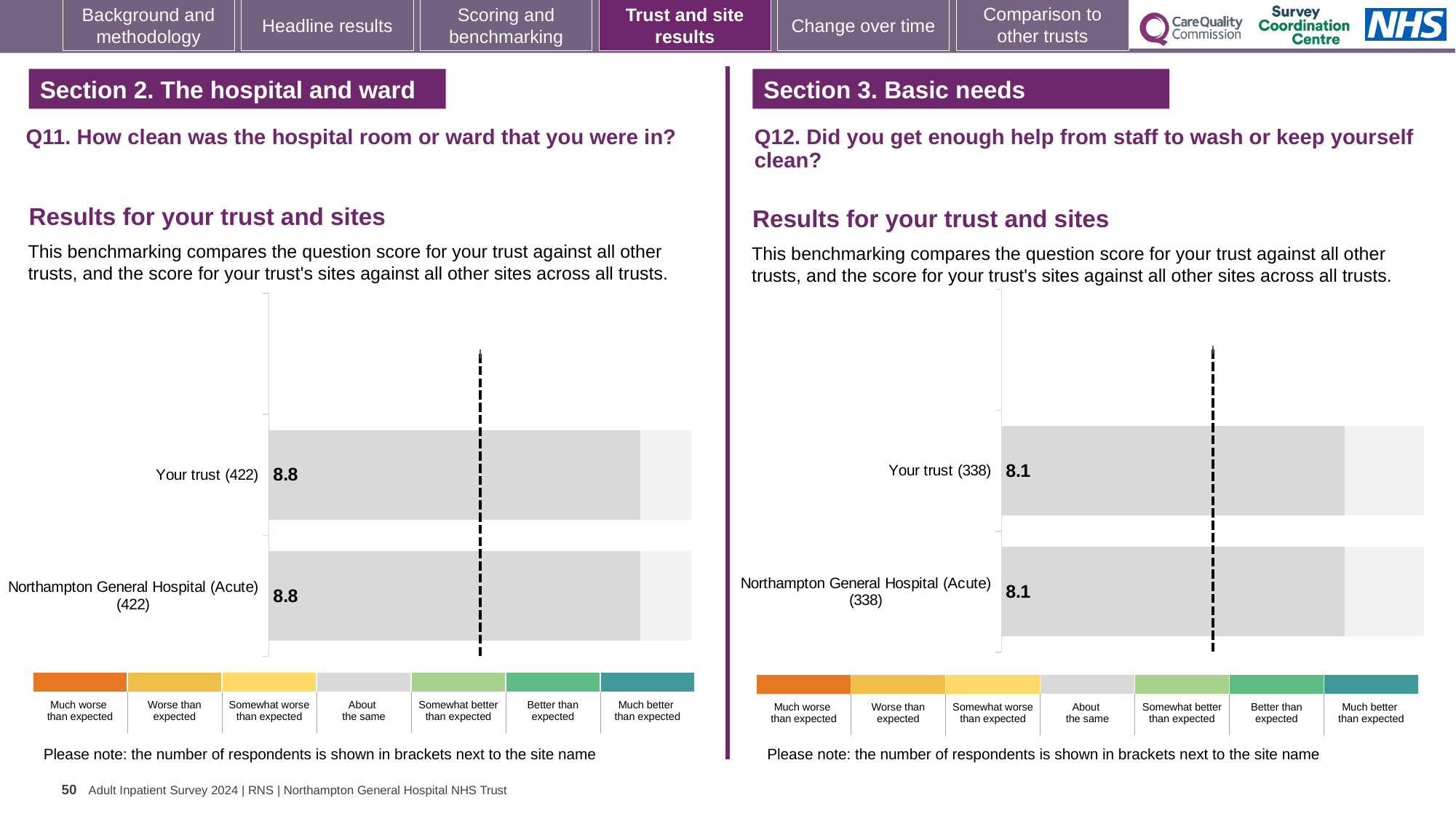
What kind of chart is used for the Q11 results on the left? Bar chart In the Q11 chart on the left, what is the difference between the score for Your trust and the score for Northampton General Hospital (Acute)? 0 In the Q11 chart on the left, what is the score for Northampton General Hospital (Acute)? 8.8 In the Q12 chart on the right, how many respondents are shown in brackets next to Northampton General Hospital (Acute)? 338 Is the score for Your trust in the Q11 chart on the left larger than the score for Your trust in the Q12 chart on the right? Yes In the Q11 chart on the left, what is the score for Your trust? 8.8 How many bars are plotted in the Q12 chart on the right? 2 In the Q11 chart on the left, how many respondents are shown in brackets next to Your trust? 422 How many bars are plotted in the Q11 chart on the left? 2 In the Q12 chart on the right, what is the score for Your trust? 8.1 In the Q12 chart on the right, what is the difference between the score for Your trust and the score for Northampton General Hospital (Acute)? 0 In the Q12 chart on the right, what is the score for Northampton General Hospital (Acute)? 8.1